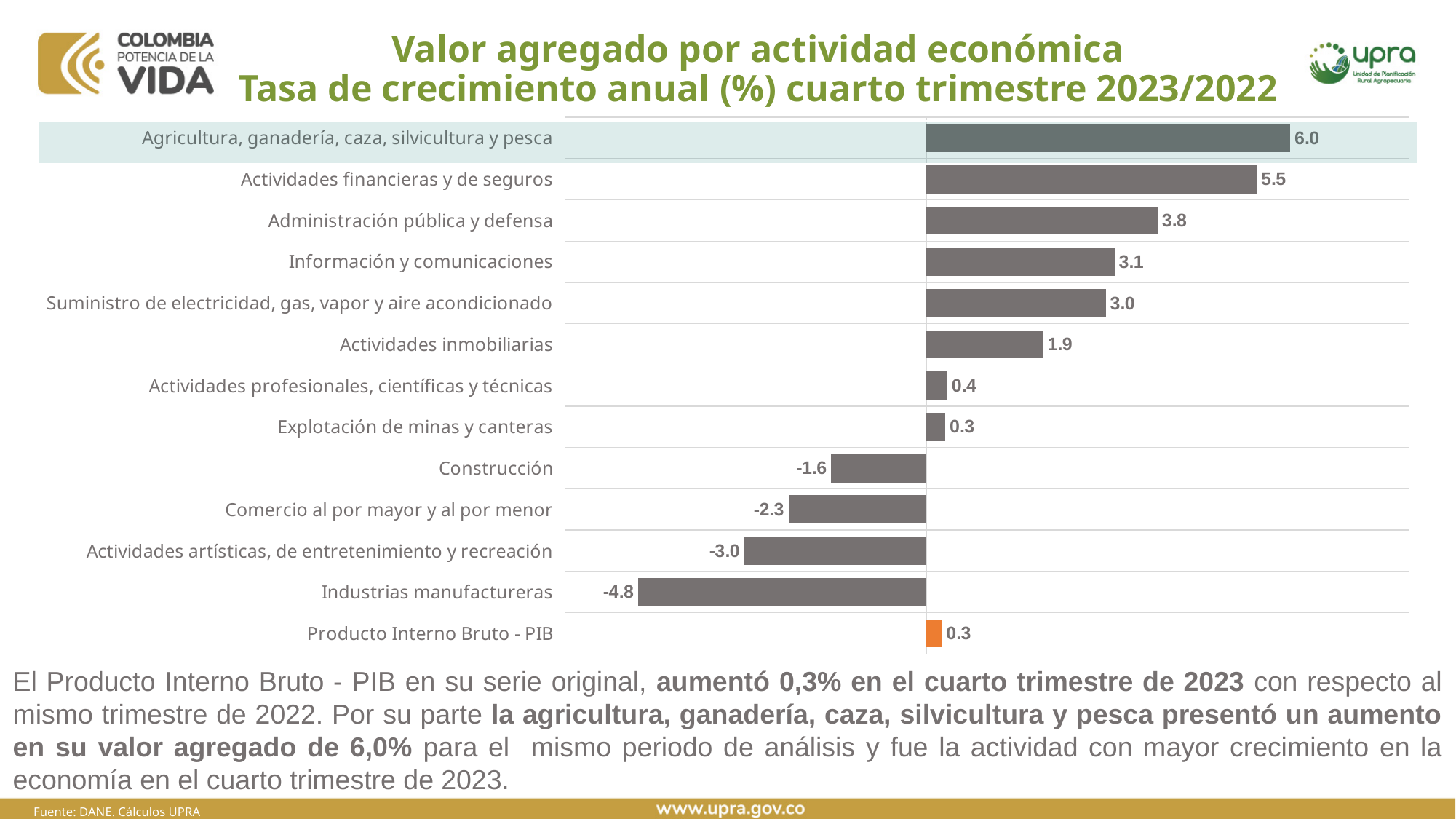
What is the annual growth rate shown for Agricultura, ganadería, caza, silvicultura y pesca? 6.0 What type of chart is shown on the slide? Bar chart Which activity has the lowest growth rate in the chart? Industrias manufactureras Which bar is shown in a different colour (orange) from the rest? Producto Interno Bruto - PIB What is the difference between the values for Actividades financieras y de seguros and Administración pública y defensa? 1.7 What value is shown for Producto Interno Bruto - PIB? 0.3 How many categories (bars) are shown in the chart? 13 What value is shown for Industrias manufactureras? -4.8 What value is shown for Actividades inmobiliarias? 1.9 Which activity has the highest growth rate in the chart? Agricultura, ganadería, caza, silvicultura y pesca Which has a larger value, Construcción or Comercio al por mayor y al por menor? Construcción What is the difference between the values for Agricultura, ganadería, caza, silvicultura y pesca and Producto Interno Bruto - PIB? 5.7